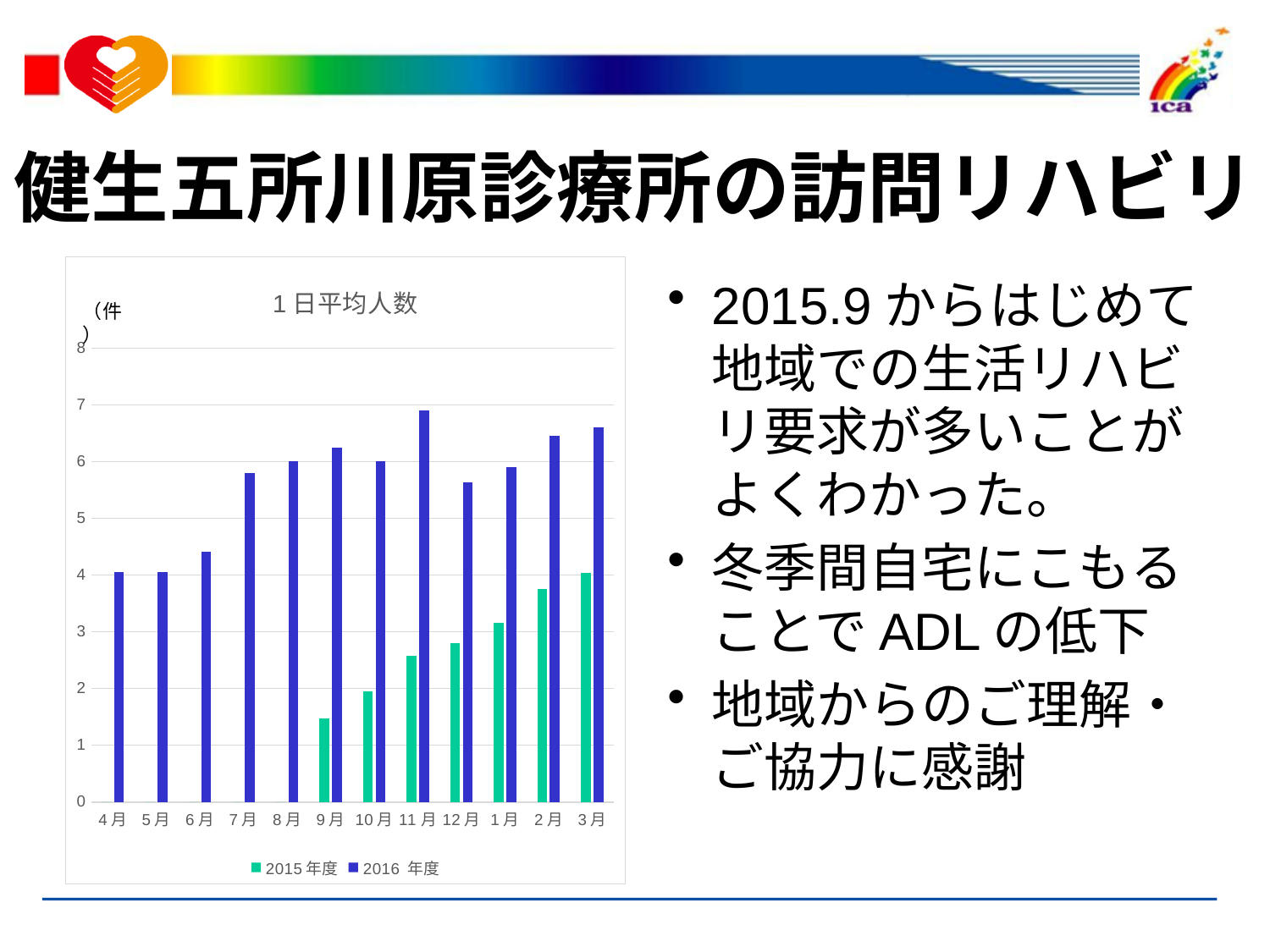
Do the values for the 2015年度 series rise or fall from 9月 to 3月? rise Which month has the highest value for the 2015年度 series? 3月 Is the value for 6月 in the 2016 年度 series greater or less than 5? less Is the value for 9月 in the 2015年度 series greater or less than 2? less What kind of chart is shown on the slide? bar chart How many months have a bar for the 2015年度 series? 7 How many months are shown on the x axis? 12 Is the value for 11月 in the 2016 年度 series greater or less than 6? greater Which month has the highest value for the 2016 年度 series? 11月 Which month has the lowest value for the 2015年度 series? 9月 What is the title of the chart? 1日平均人数 How many series does the legend list? 2